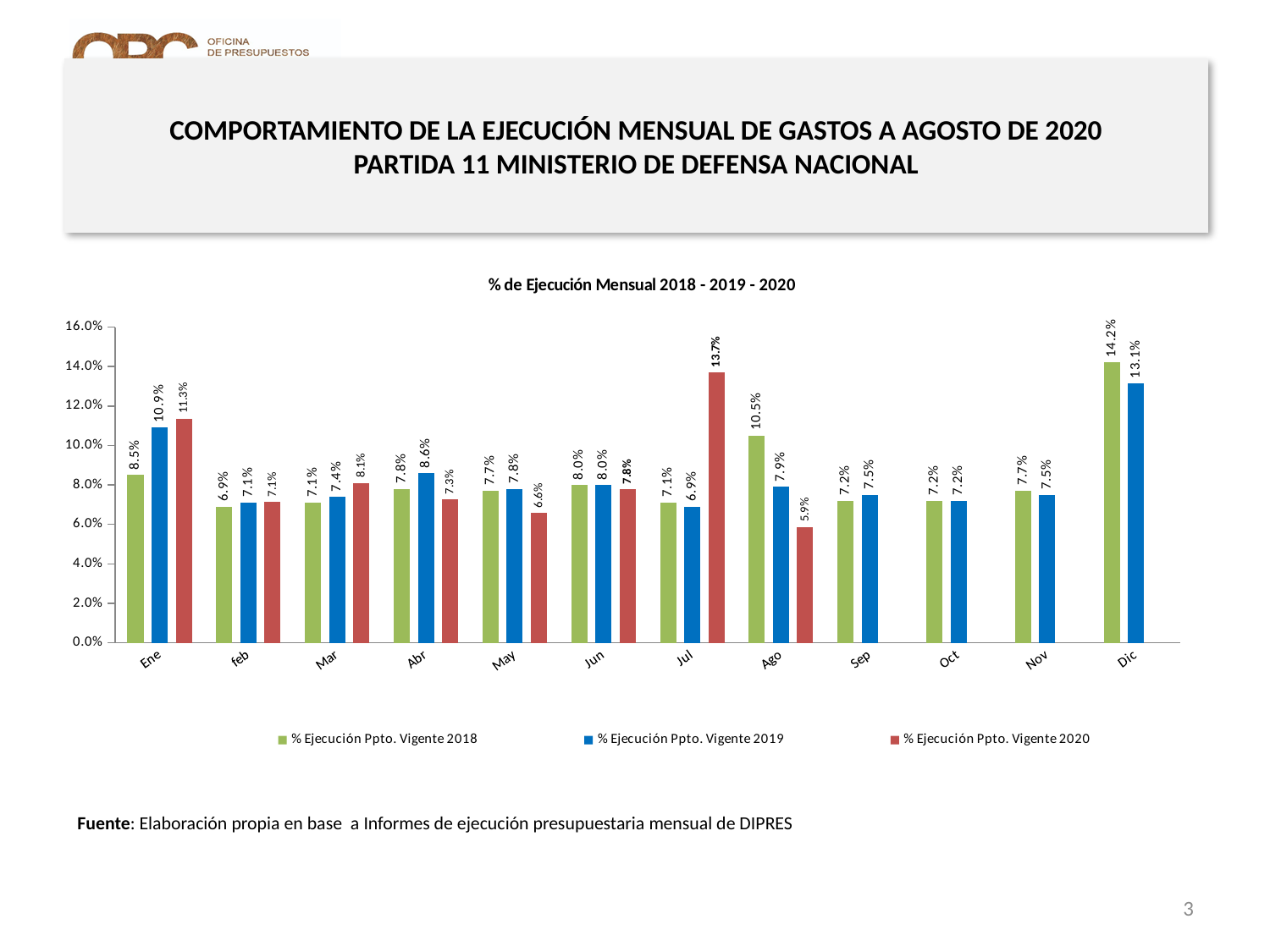
What is the value for % Ejecución Ppto. Vigente 2020 in Jul? 13.7% How many series does the legend list? 3 What is the value for % Ejecución Ppto. Vigente 2018 in Ago? 10.5% In which month is the % Ejecución Ppto. Vigente 2020 series lowest? Ago How many months are shown on the x axis? 12 Is the value for % Ejecución Ppto. Vigente 2019 in Dic greater or less than 12.0%? greater What is the title of the chart? % de Ejecución Mensual 2018 - 2019 - 2020 What kind of chart is shown on the slide? Bar chart What is the difference between the 2020 and 2019 values in Jul? 6.8% Which is larger in Abr: the 2019 value or the 2020 value? 2019 (8.6%) What is the value for % Ejecución Ppto. Vigente 2019 in Ene? 10.9% In which month is the % Ejecución Ppto. Vigente 2018 series highest? Dic